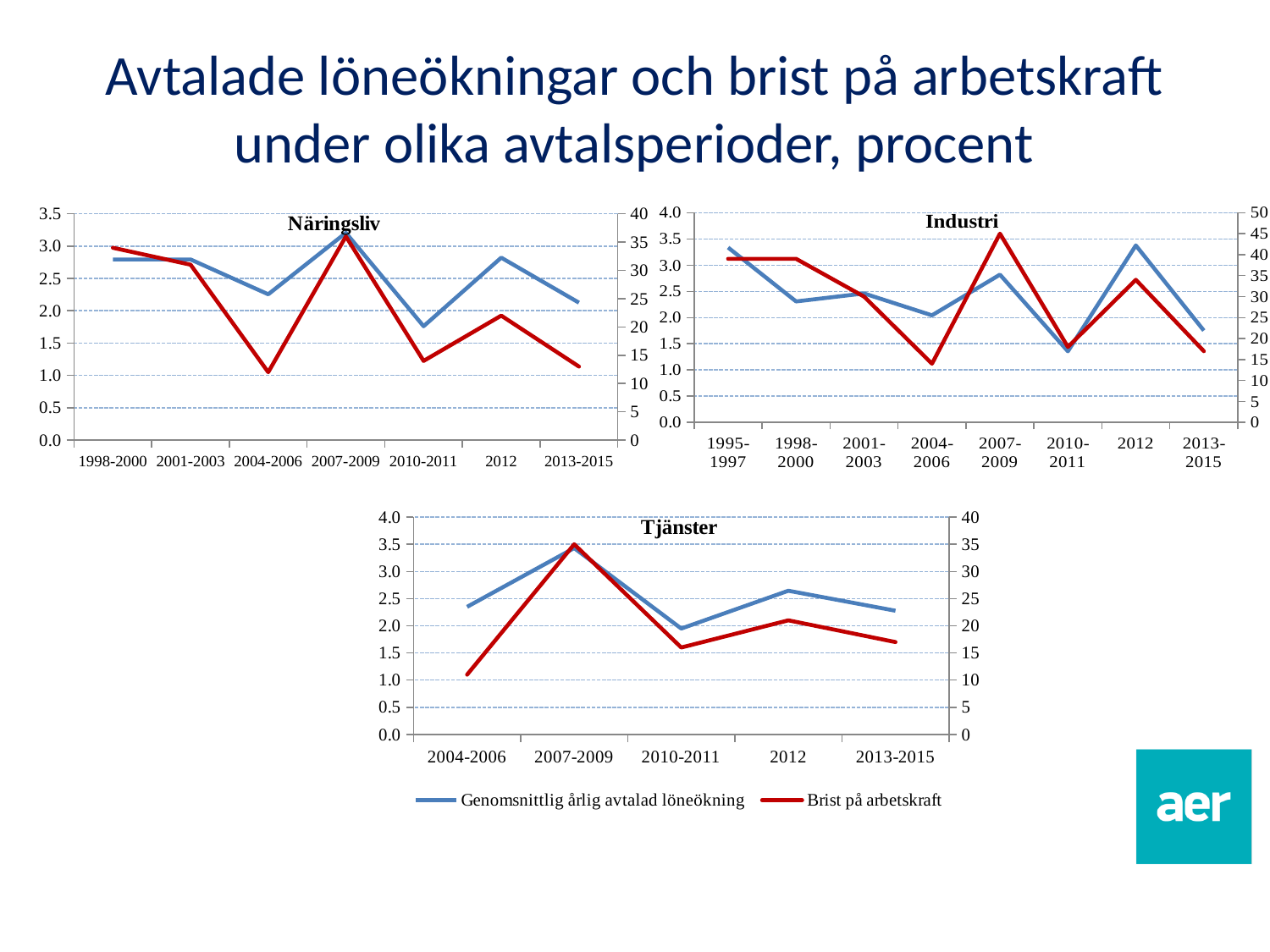
In the Tjänster chart, does Genomsnittlig årlig avtalad löneökning rise or fall from 2012 to 2013-2015? fall Which series is drawn in red in the charts? Brist på arbetskraft In the Näringsliv chart, in which period is Genomsnittlig årlig avtalad löneökning highest? 2007-2009 In the Tjänster chart, in which period is Brist på arbetskraft lowest? 2004-2006 How many periods are shown on the x axis of the Industri chart? 8 In the Näringsliv chart, is the value of Genomsnittlig årlig avtalad löneökning for 2004-2006 greater or less than 2.0? greater In the Industri chart, is the value of Brist på arbetskraft for 2004-2006 greater or less than 20? less What kind of chart is the Näringsliv chart? line chart In the Industri chart, in which period is Brist på arbetskraft highest? 2007-2009 How many series does the legend at the bottom of the slide list? 2 In the Industri chart, in which period is Genomsnittlig årlig avtalad löneökning lowest? 2010-2011 How many periods are shown on the x axis of the Tjänster chart? 5